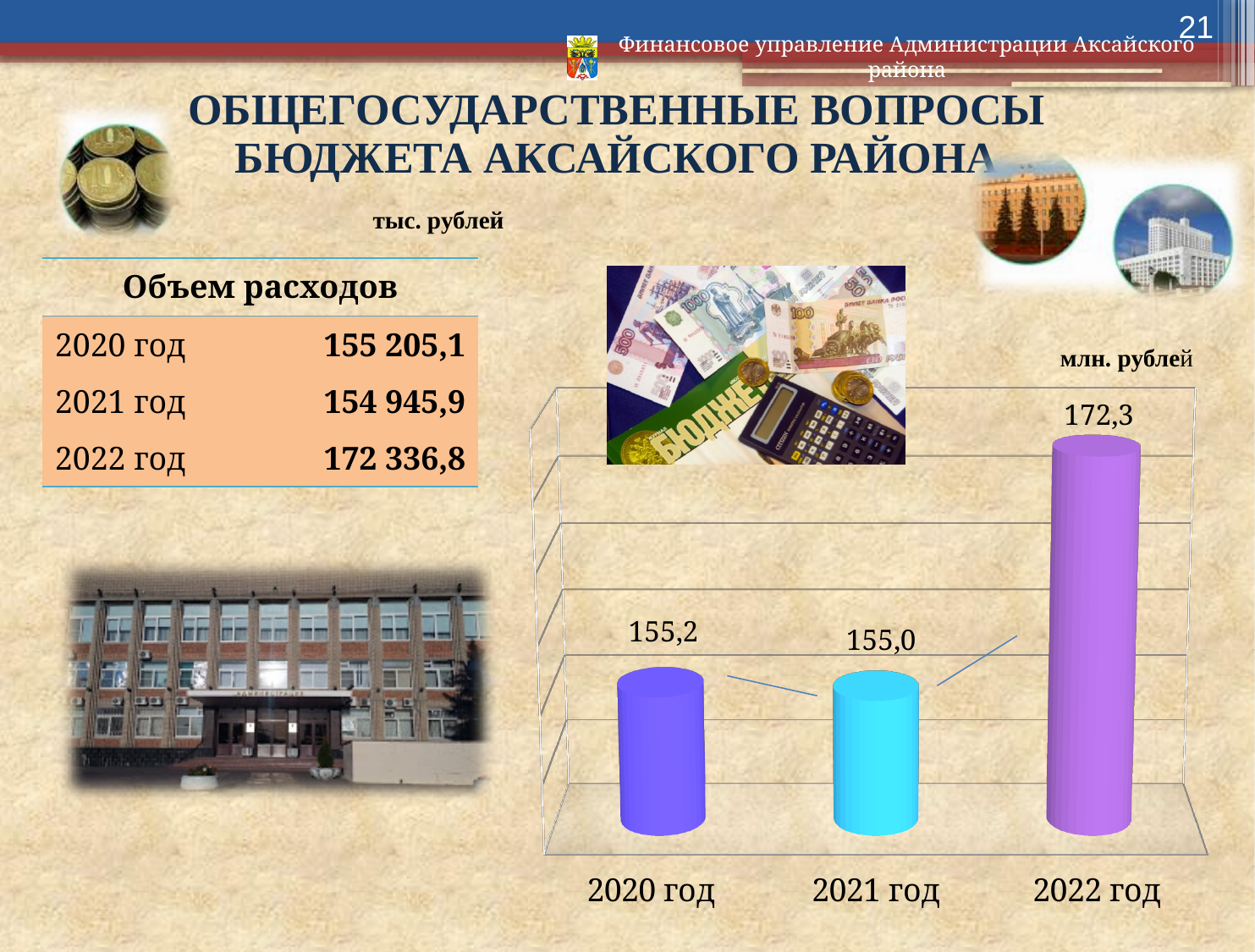
What unit is indicated above the chart? млн. рублей From 2021 год to 2022 год, does the value on the chart rise or fall? rise Which is larger on the chart, the value for 2022 год or the value for 2020 год? 2022 год What is the difference between the values for 2022 год and 2020 год on the chart? 17,1 What is the difference between the values for 2020 год and 2021 год on the chart? 0,2 How many years (categories) are shown on the chart? 3 What value is shown for 2021 год on the chart? 155,0 What value is shown for 2020 год on the chart? 155,2 What value is shown for 2022 год on the chart? 172,3 Which year has the highest value on the chart? 2022 год What is the difference between the values for 2022 год and 2021 год on the chart? 17,3 What kind of chart is shown on the slide? bar chart